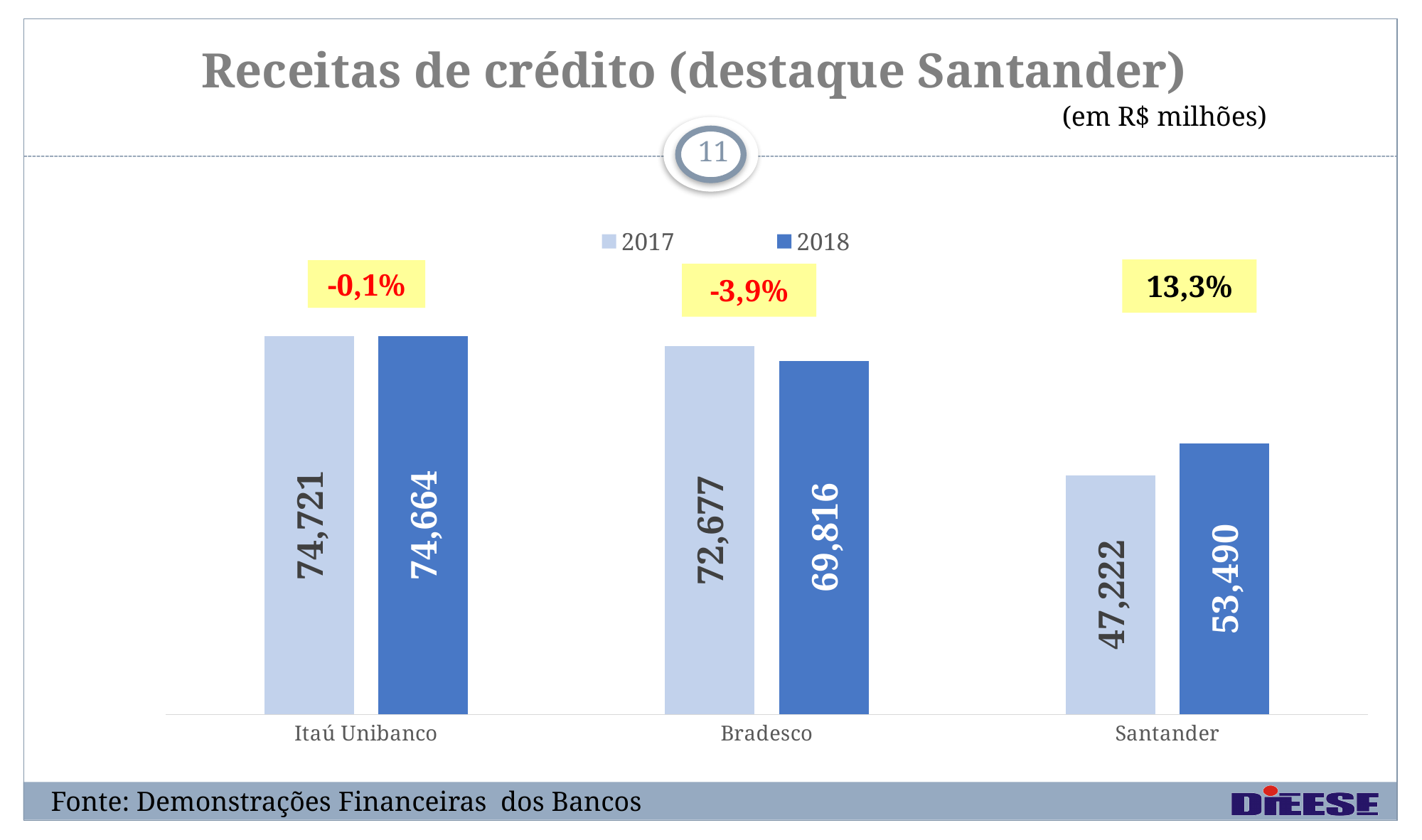
What is the difference between Santander's 2018 and 2017 values? 6,268 What is the difference between Bradesco's 2017 and 2018 values? 2,861 How many series does the legend list? 2 What is the 2017 value for Itaú Unibanco? 74,721 Which bank has the lowest 2017 value? Santander How many banks are shown on the x axis? 3 For Bradesco, which is larger, the 2017 value or the 2018 value? 2017 What is the 2018 value for Bradesco? 69,816 What kind of chart is shown on the slide? bar chart What percentage change is shown above the Santander bars? 13,3% What is the 2017 value for Santander? 47,222 Which bank has the highest 2018 value? Itaú Unibanco